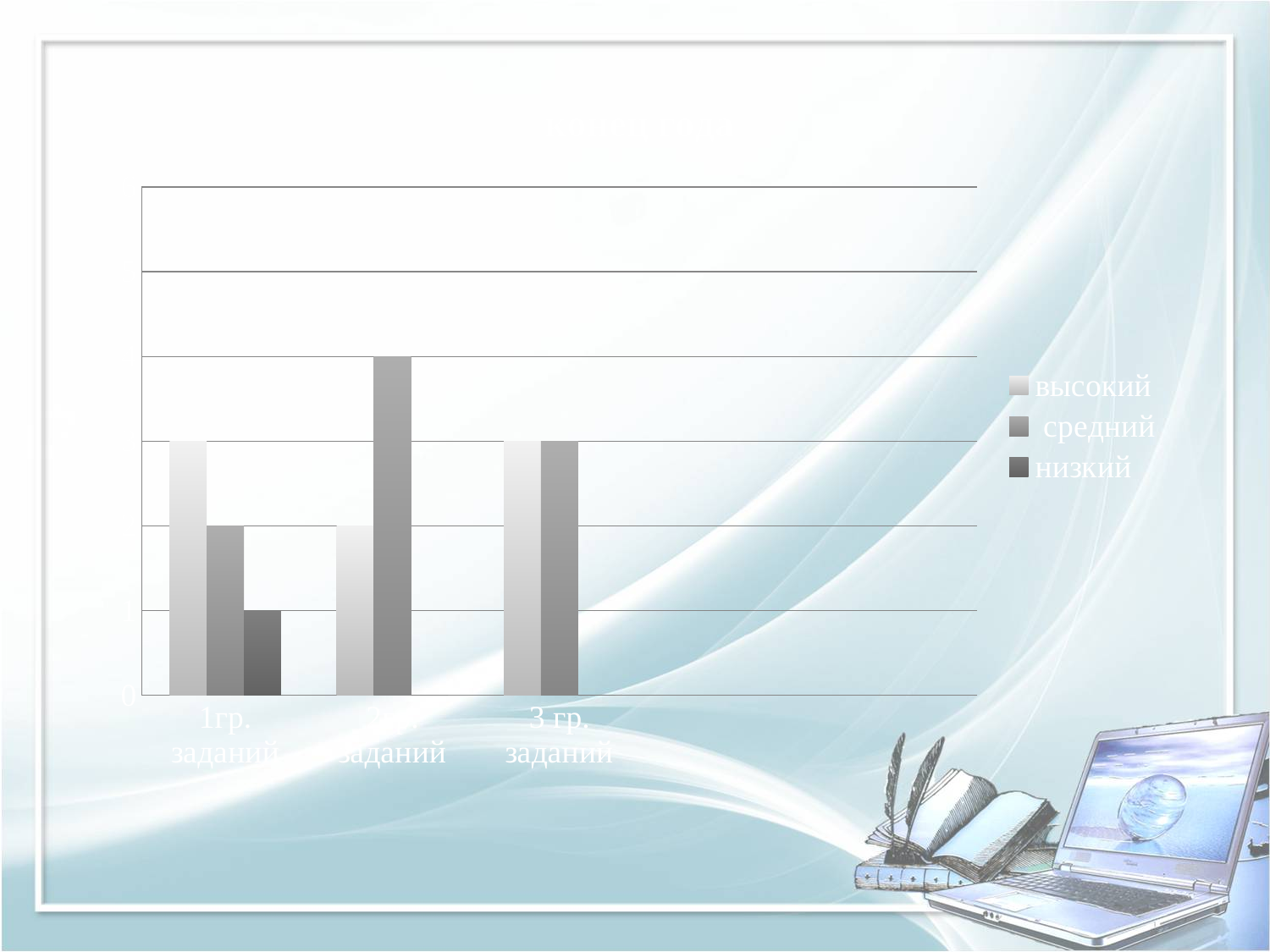
How many categories are shown on the x axis? 3 Which series has the tallest bar in the whole chart? средний In the category 2 гр. заданий, which is larger: высокий or средний? средний What kind of chart is shown on the slide? bar chart Which is larger: the высокий bar for 1гр. заданий or the высокий bar for 2 гр. заданий? 1гр. заданий Which category has the tallest средний bar? 2 гр. заданий In the category 1гр. заданий, which is larger: высокий or средний? высокий What are the three series named in the legend? высокий, средний, низкий In the category 1гр. заданий, which series has the lowest bar? низкий How many series does the legend list? 3 Which category has the shortest высокий bar? 2 гр. заданий Which category is the only one with a visible низкий bar? 1гр. заданий